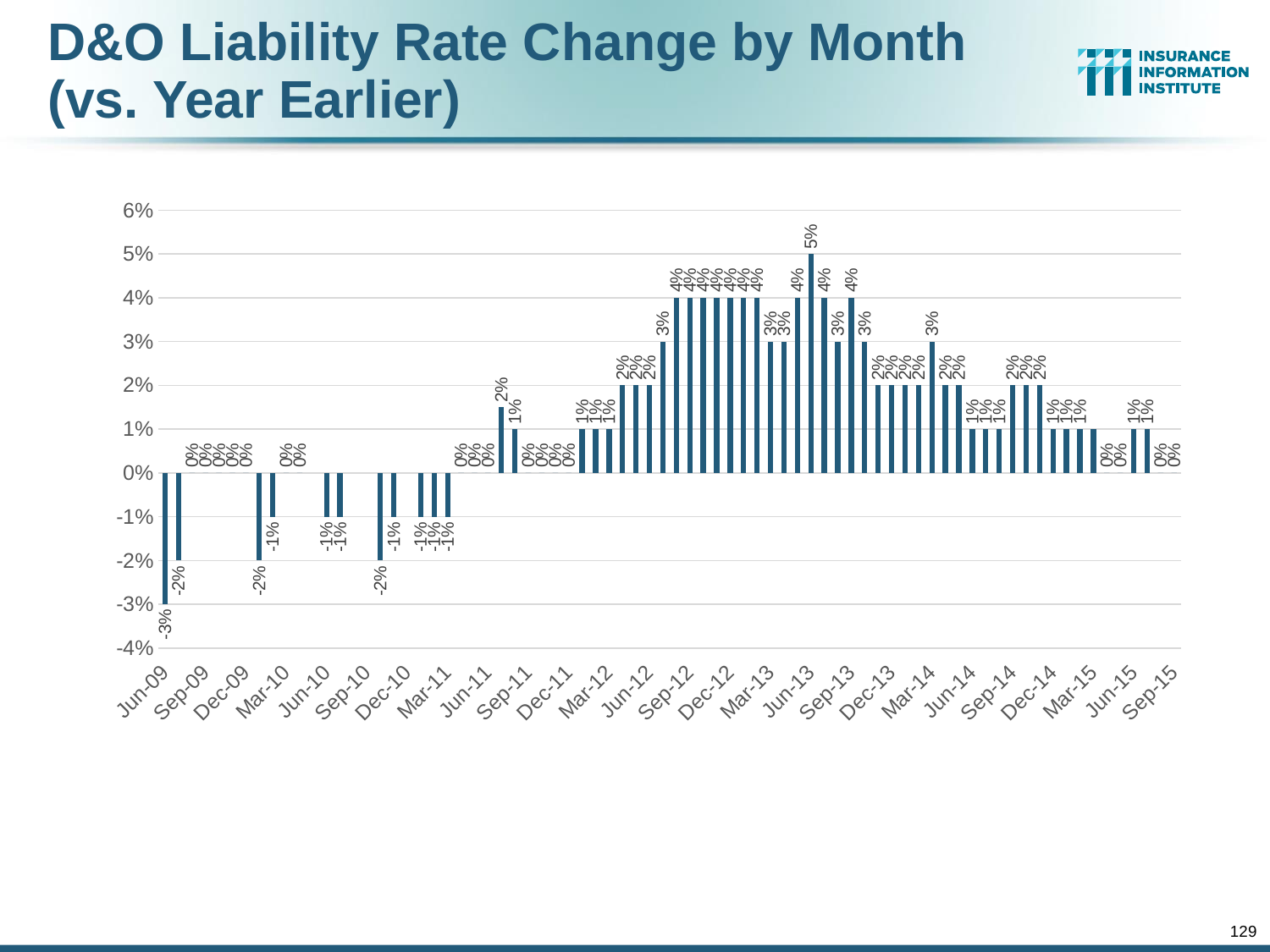
What is the highest value shown on the vertical axis? 6% Which is larger, the rate change for Jun-09 or for Sep-15? Sep-15 What is the rate change value for Jun-09, the first month on the chart? -3% Do the values generally rise or fall from Jun-09 to mid-2013? Rise Is the highest bar on the chart greater or less than 4%? greater What is the rate change value for Sep-15, the last month on the chart? 0% What is the difference between the highest value (5%) and the lowest value (-3%) on the chart? 8 percentage points What is the highest rate change value shown on the chart? 5% What is the title of the chart on the slide? D&O Liability Rate Change by Month (vs. Year Earlier) Is the value for Jun-09 greater or less than -2%? less What kind of chart is shown on the slide? Bar chart What is the lowest rate change value shown on the chart? -3%